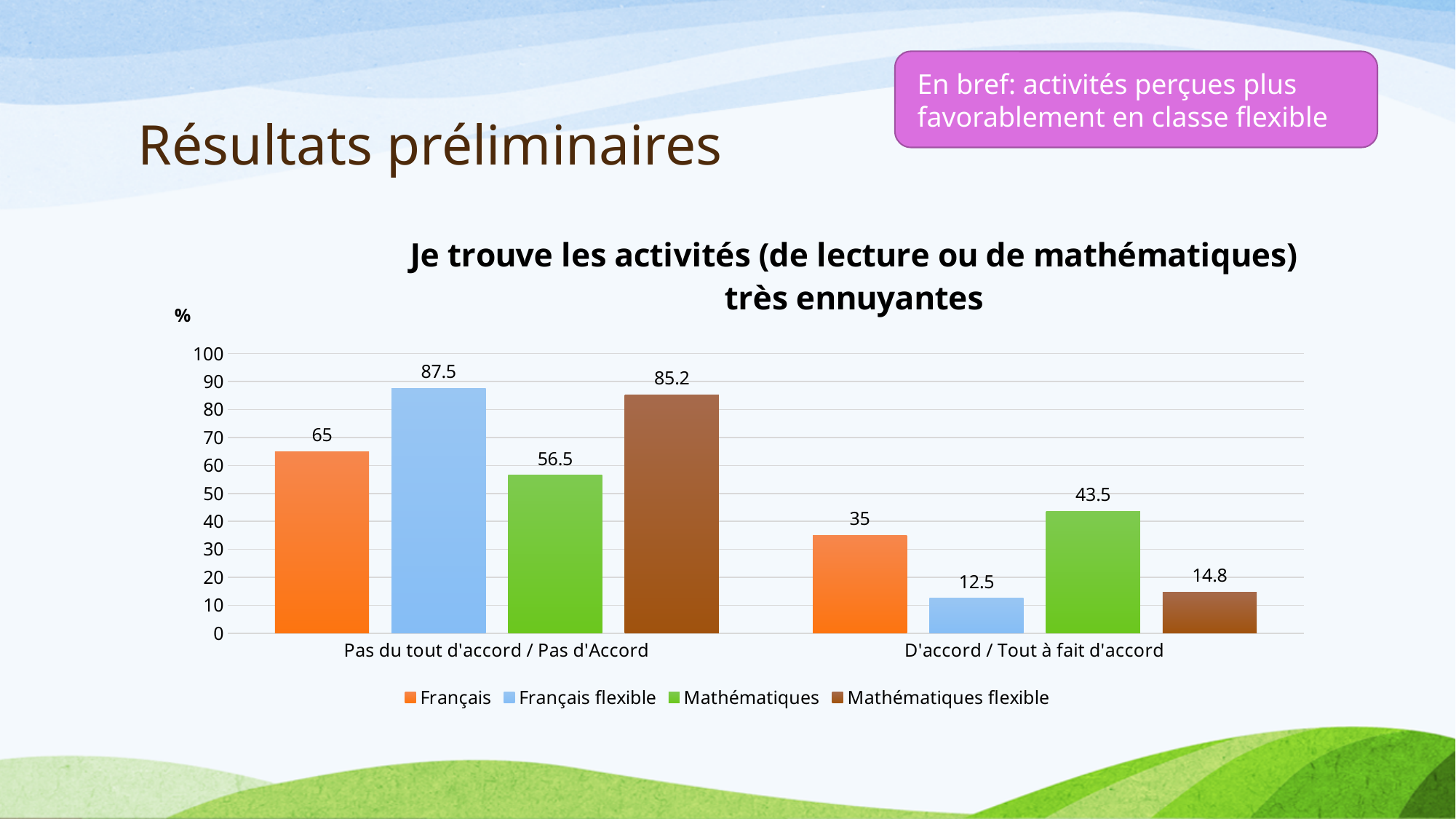
What is the difference between the Français and Français flexible values in the 'Pas du tout d'accord / Pas d'Accord' category? 22.5 Which series has the lowest value in the 'D'accord / Tout à fait d'accord' category? Français flexible What is the value for Mathématiques in the 'D'accord / Tout à fait d'accord' category? 43.5 In the 'D'accord / Tout à fait d'accord' category, which is larger: Français or Mathématiques? Mathématiques What is the value for Français flexible in the 'Pas du tout d'accord / Pas d'Accord' category? 87.5 What is the title of the chart? Je trouve les activités (de lecture ou de mathématiques) très ennuyantes What is the difference between the Mathématiques and Mathématiques flexible values in the 'D'accord / Tout à fait d'accord' category? 28.7 Is the value for Mathématiques in the 'Pas du tout d'accord / Pas d'Accord' category greater or less than 50? greater What kind of chart is shown on the slide? Bar chart What is the value for Mathématiques flexible in the 'Pas du tout d'accord / Pas d'Accord' category? 85.2 How many series does the legend list? 4 Which series has the highest value in the 'Pas du tout d'accord / Pas d'Accord' category? Français flexible